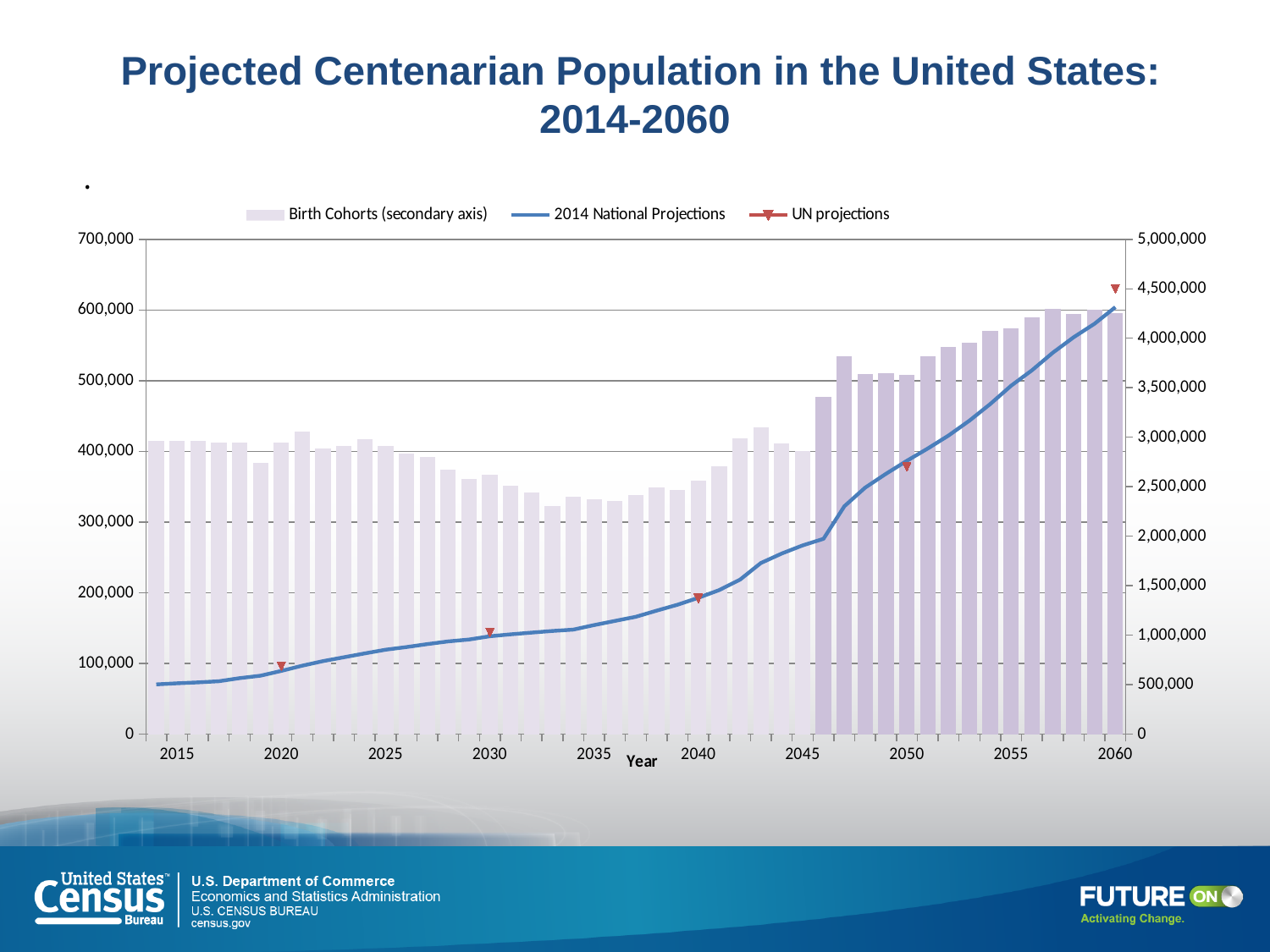
Which is larger for the 2014 National Projections series: the value in 2015 or the value in 2060? 2060 Is the 2014 National Projections value for 2060 greater or less than 500,000? greater Is the Birth Cohorts value for 2060 on the secondary axis greater or less than 4,000,000? greater How many UN projections markers are plotted on the chart? 5 How many series does the legend list? 3 Is the UN projections value for 2030 greater or less than 100,000? greater What kind of chart is shown on the slide? A combination bar and line chart Does the 2014 National Projections line rise or fall from 2015 to 2060? Rises What is the label on the x axis of the chart? Year